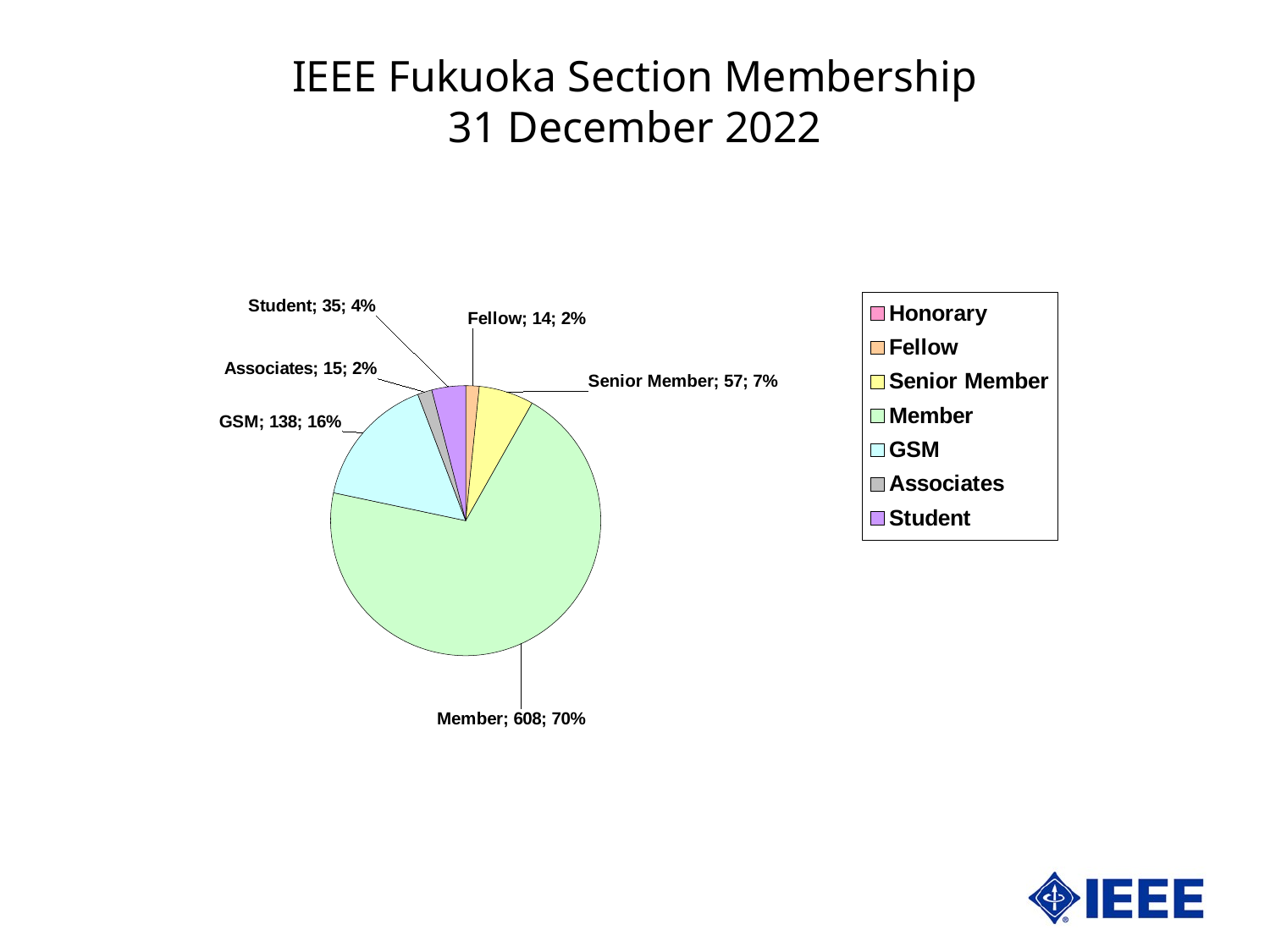
What share of the pie does the Student slice represent? 4% What is the difference between the number of GSM members and the number of Senior Members? 81 What is the value shown for the Fellow category? 14 What is the title of the slide containing the pie chart? IEEE Fukuoka Section Membership 31 December 2022 Which category has the largest slice of the pie? Member What share of the pie does the GSM slice represent? 16% What share of the pie does the Member slice represent? 70% How many members are in the Senior Member category? 57 Which is larger, the Student count or the Associates count? Student What kind of chart is shown on the slide? pie chart How many members are in the Member category? 608 How many entries does the legend list? 7